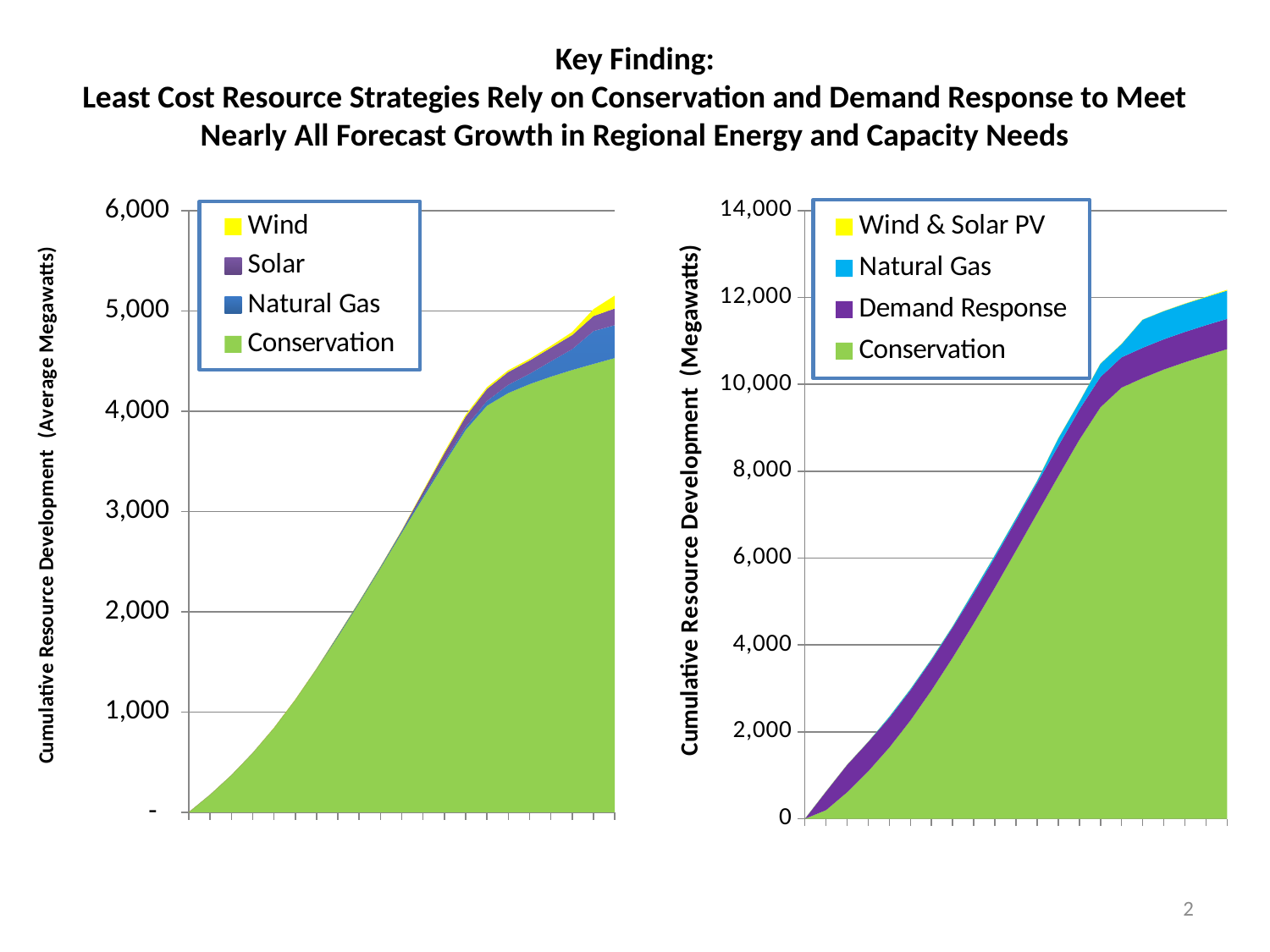
In the right chart, is the final value of the Conservation area greater or less than 10,000? greater In the left chart, is the final value of the Conservation area greater or less than 4,000? greater In the right chart, which series accounts for the largest share of cumulative resource development? Conservation How many series does the legend of the left chart list? 4 In the right chart, which colour represents Demand Response? Purple In the left chart, does cumulative resource development rise or fall along the x axis? Rise How many series does the legend of the right chart list? 4 In the left chart, which series accounts for the largest share of cumulative resource development? Conservation What type of chart is the left chart on the slide? Stacked area chart In the right chart, which series accounts for the smallest share of cumulative resource development? Wind & Solar PV In the left chart, which contributes more to cumulative resource development, Conservation or Natural Gas? Conservation What is the y-axis label of the right chart? Cumulative Resource Development (Megawatts)